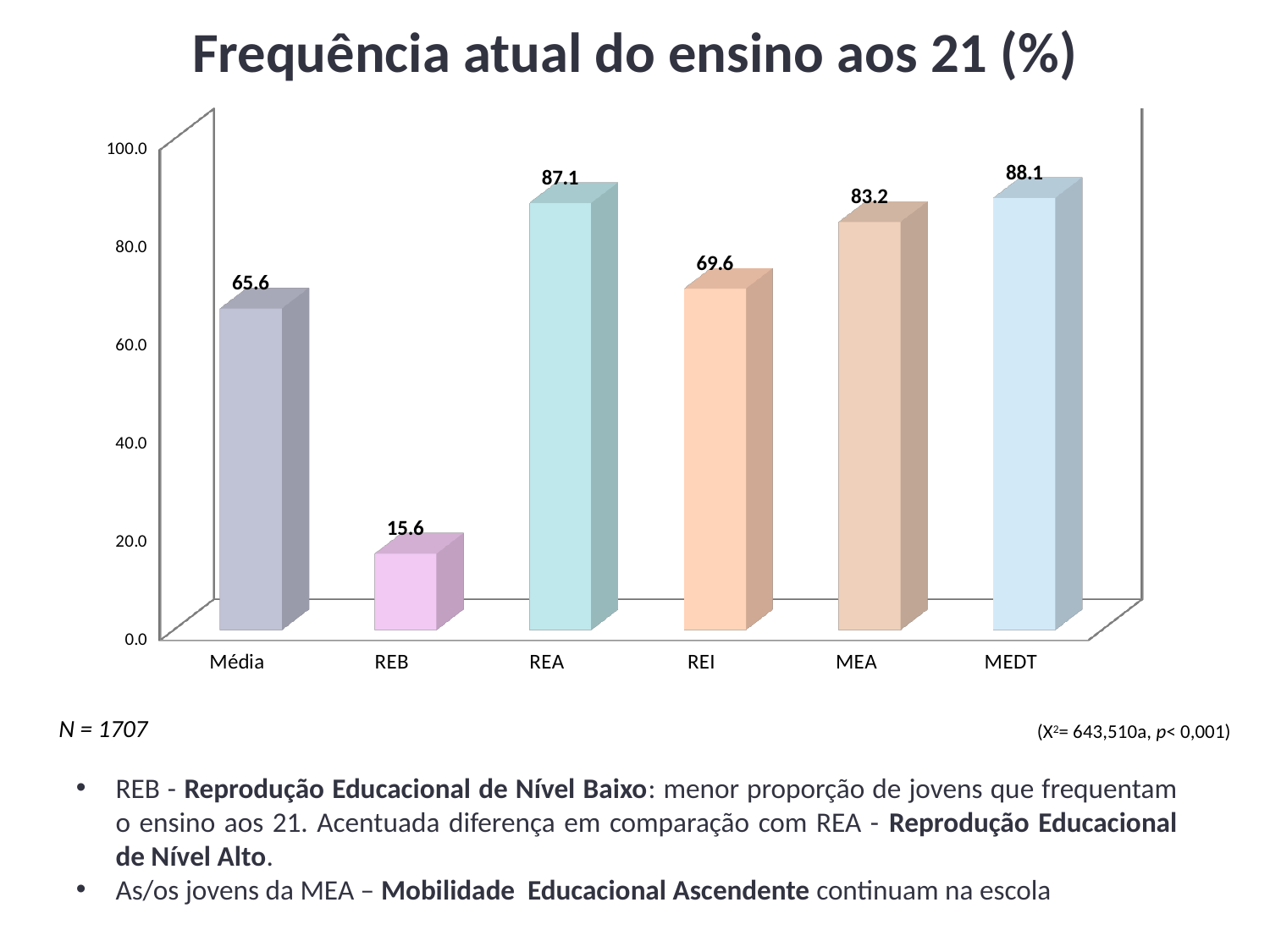
What is the value for REB? 15.6 How many categories are shown on the x axis? 6 What is the value for MEA? 83.2 Is the value for REI greater or less than 60.0? greater Which category has the lowest value? REB What is the difference between the values for MEDT and MEA? 4.9 What kind of chart is shown on the slide? bar chart What is the title of the chart? Frequência atual do ensino aos 21 (%) Which category has the highest value? MEDT Which is larger, the value for REI or the value for MEA? MEA What is the difference between the values for REA and REB? 71.5 What is the value for Média? 65.6